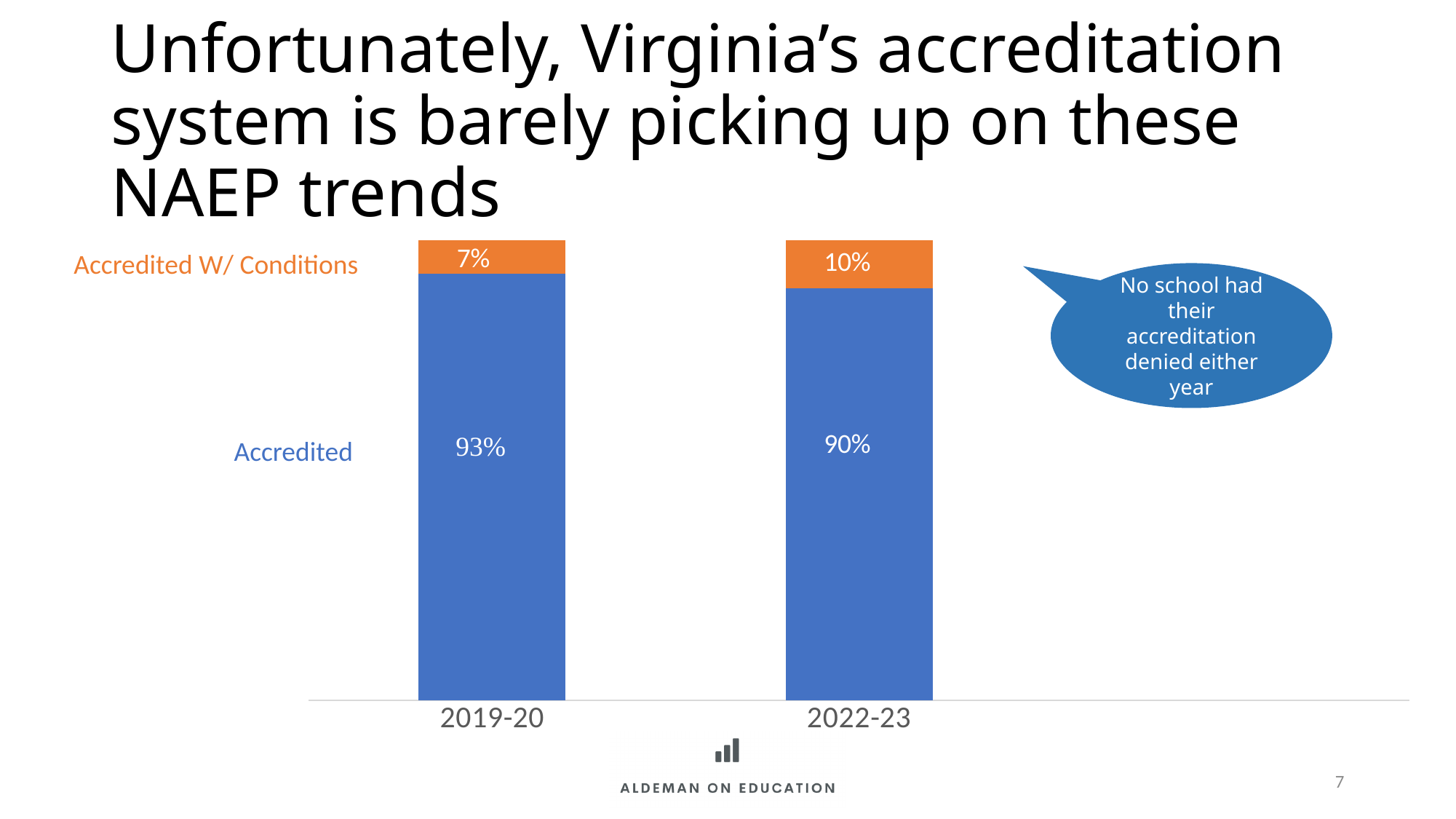
What percentage of schools were Accredited in 2022-23? 90% By how many percentage points did the Accredited share fall from 2019-20 to 2022-23? 3 percentage points Which year had the lower share of schools Accredited? 2022-23 How many series are shown in the chart? 2 Does the Accredited W/ Conditions share rise or fall from 2019-20 to 2022-23? Rise What percentage of schools were Accredited W/ Conditions in 2022-23? 10% Which year had the higher share of schools Accredited W/ Conditions? 2022-23 What percentage of schools were Accredited in 2019-20? 93% What kind of chart is shown on the slide? Stacked bar chart How many years (categories) are shown on the x axis? 2 Is the Accredited share larger in 2019-20 or in 2022-23? 2019-20 What percentage of schools were Accredited W/ Conditions in 2019-20? 7%